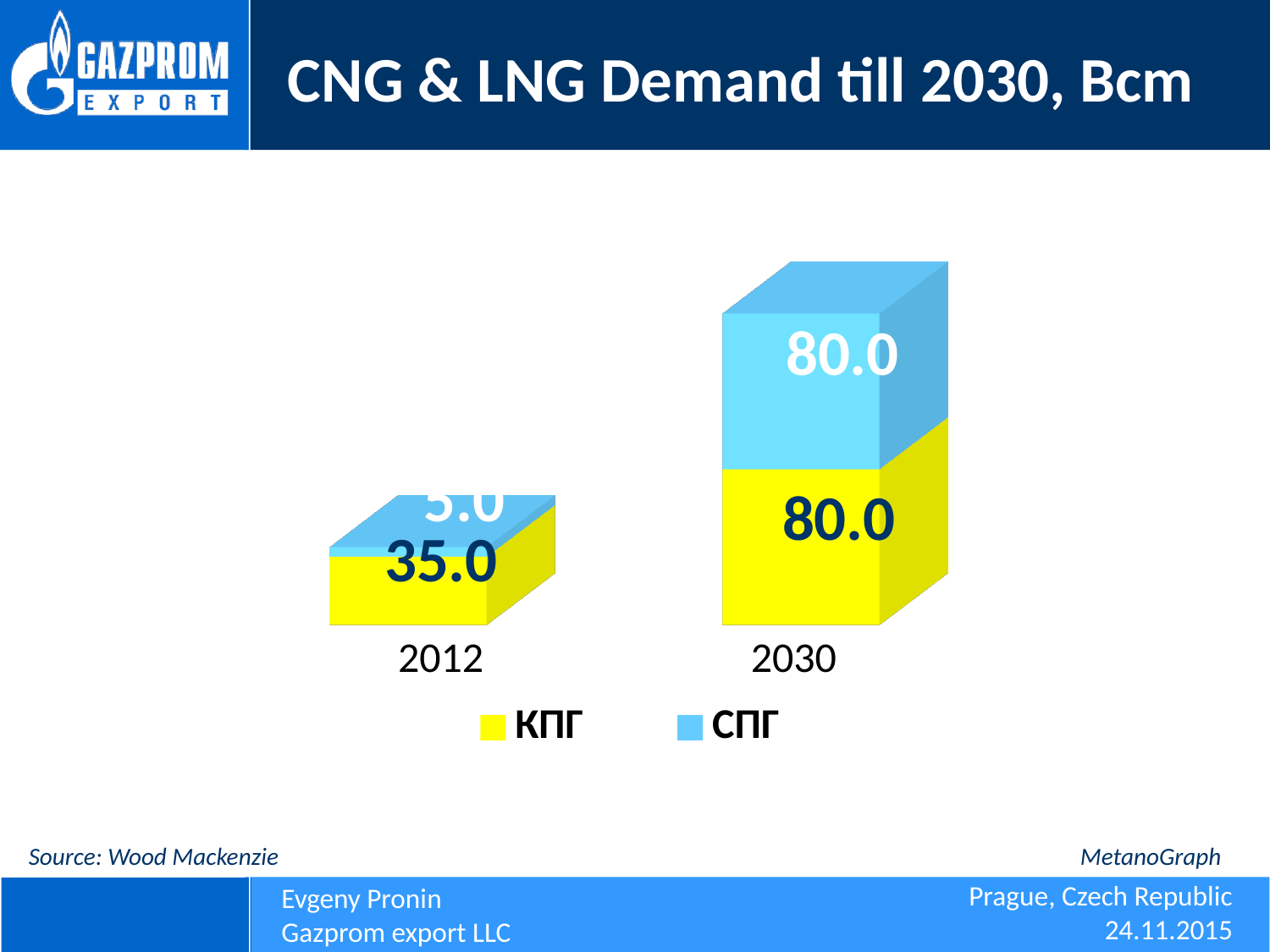
In 2012, which series has the larger value, КПГ or СПГ? КПГ What is the difference between the КПГ value in 2030 and the КПГ value in 2012? 45.0 What is the value for КПГ in 2012? 35.0 What kind of chart is shown on the slide? Stacked bar chart What is the total of the stacked bar for 2030? 160.0 What is the value for СПГ in 2030? 80.0 How many categories (years) are shown on the x axis? 2 Which year has the larger КПГ value, 2012 or 2030? 2030 How many series does the legend list? 2 What is the title of the chart? CNG & LNG Demand till 2030, Bcm Which year has the taller stacked bar? 2030 What is the value for КПГ in 2030? 80.0